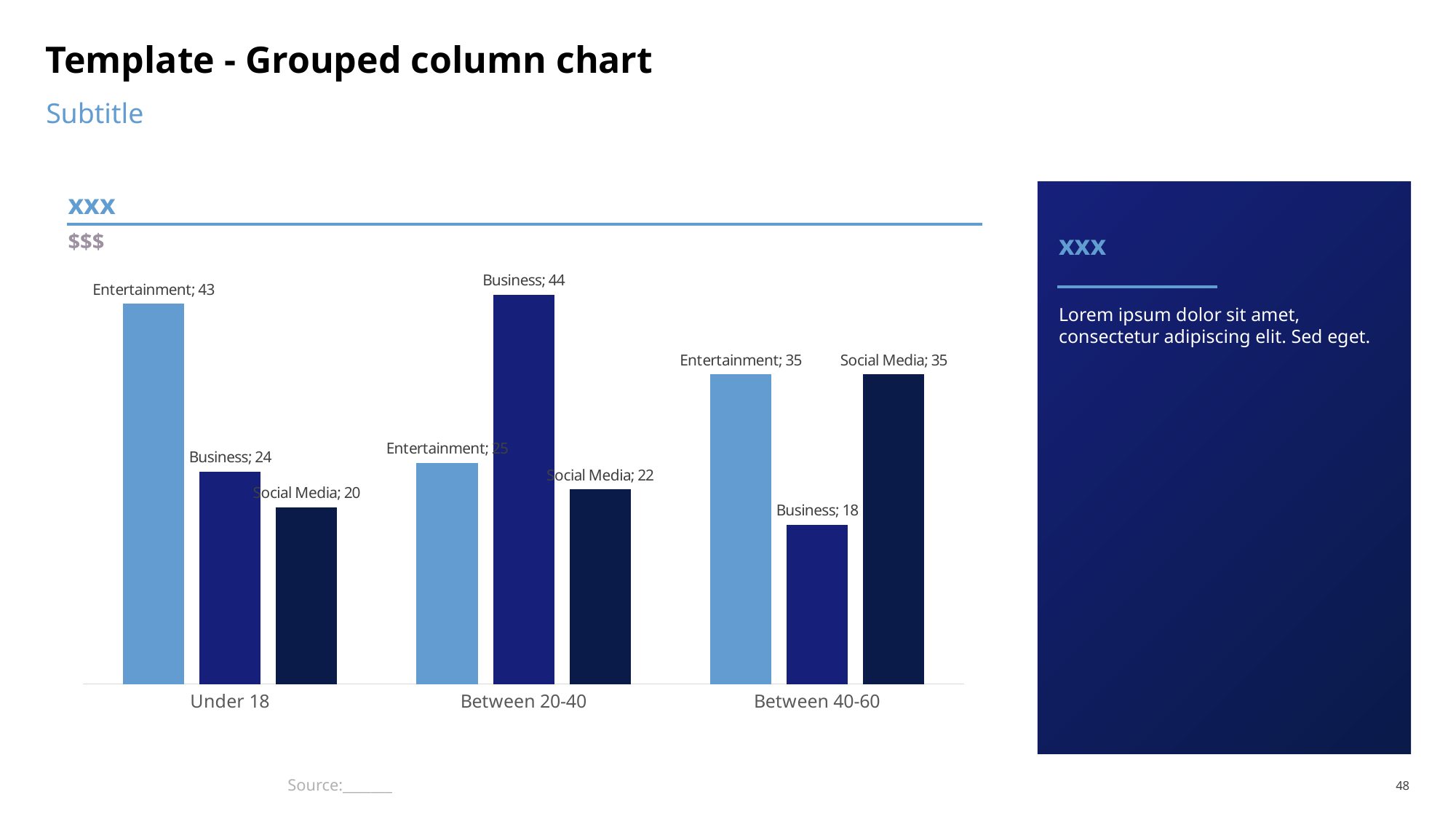
What is the value for Business in the Between 40-60 category? 18 What is the value for Entertainment in the Under 18 category? 43 Which series has the highest value in the Under 18 category? Entertainment What is the value for Business in the Between 20-40 category? 44 Which series has the lowest value in the Between 40-60 category? Business What is the difference between the Entertainment value for Under 18 and the Entertainment value for Between 40-60? 8 How many age categories are shown on the x axis? 3 What is the difference between the Business value and the Social Media value in the Between 20-40 category? 22 What is the value for Social Media in the Between 40-60 category? 35 Which is larger: Business for Under 18 or Business for Between 40-60? Business for Under 18 What kind of chart is shown on the slide? Bar chart How do the Business values change across the categories from Under 18 to Between 40-60? Rise then fall